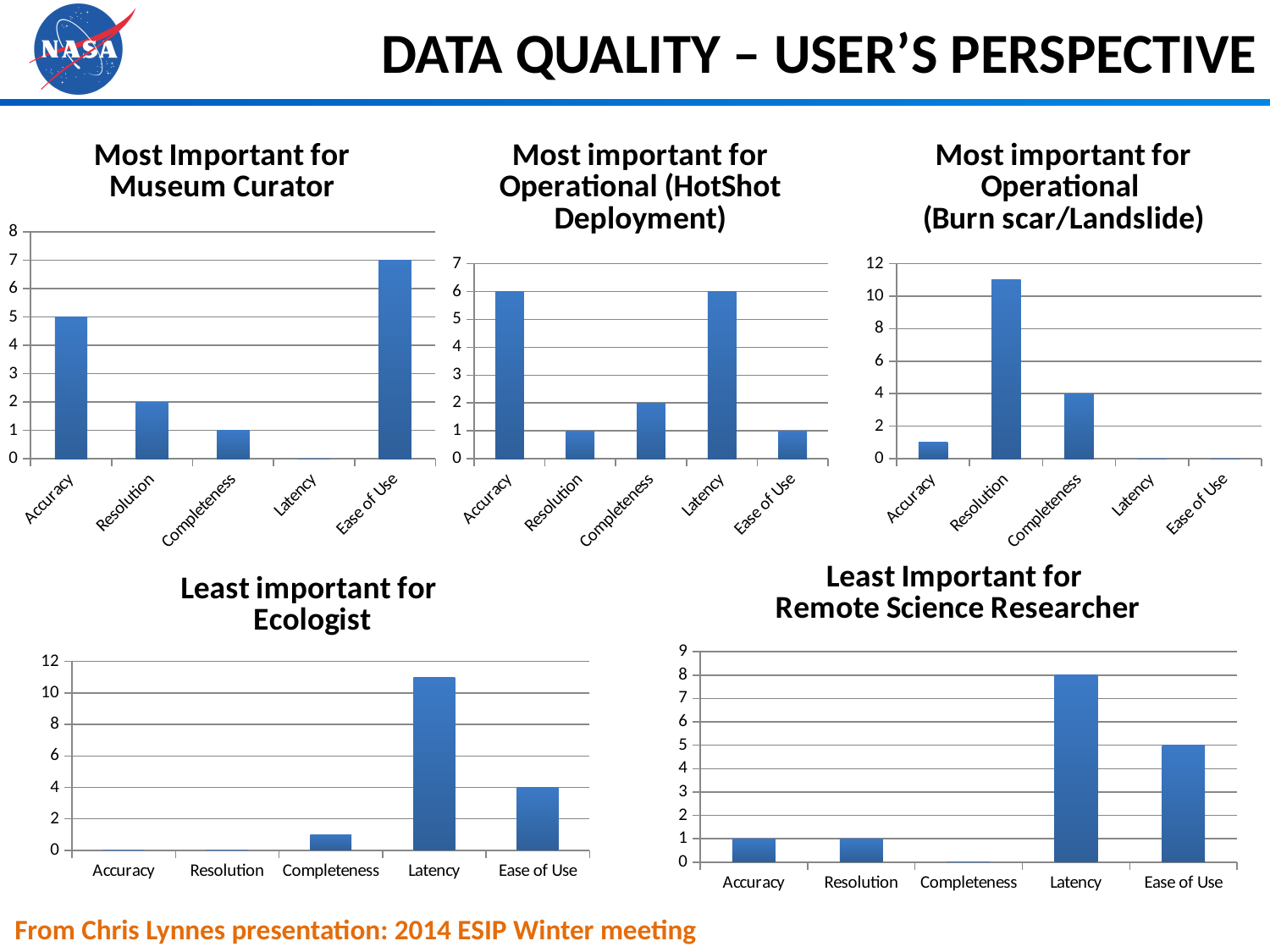
How many categories are shown on the x axis of the 'Least Important for Remote Science Researcher' chart? 5 In the 'Most important for Operational (HotShot Deployment)' chart, what is the value for Latency? 6 In the 'Most important for Operational (HotShot Deployment)' chart, which is larger, Completeness or Resolution? Completeness In the 'Least important for Ecologist' chart, which category has the highest value? Latency In the 'Least important for Ecologist' chart, is the value for Latency greater or less than 10? greater In the 'Most Important for Museum Curator' chart, which category has the highest value? Ease of Use In the 'Least Important for Remote Science Researcher' chart, what is the difference between Latency and Ease of Use? 3 In the 'Least Important for Remote Science Researcher' chart, what is the value for Latency? 8 In the 'Most Important for Museum Curator' chart, what is the difference between Ease of Use and Accuracy? 2 In the 'Most Important for Museum Curator' chart, what is the value for Ease of Use? 7 In the 'Most important for Operational (Burn scar/Landslide)' chart, is the value for Resolution greater or less than 10? greater In the 'Most important for Operational (Burn scar/Landslide)' chart, what is the value for Completeness? 4